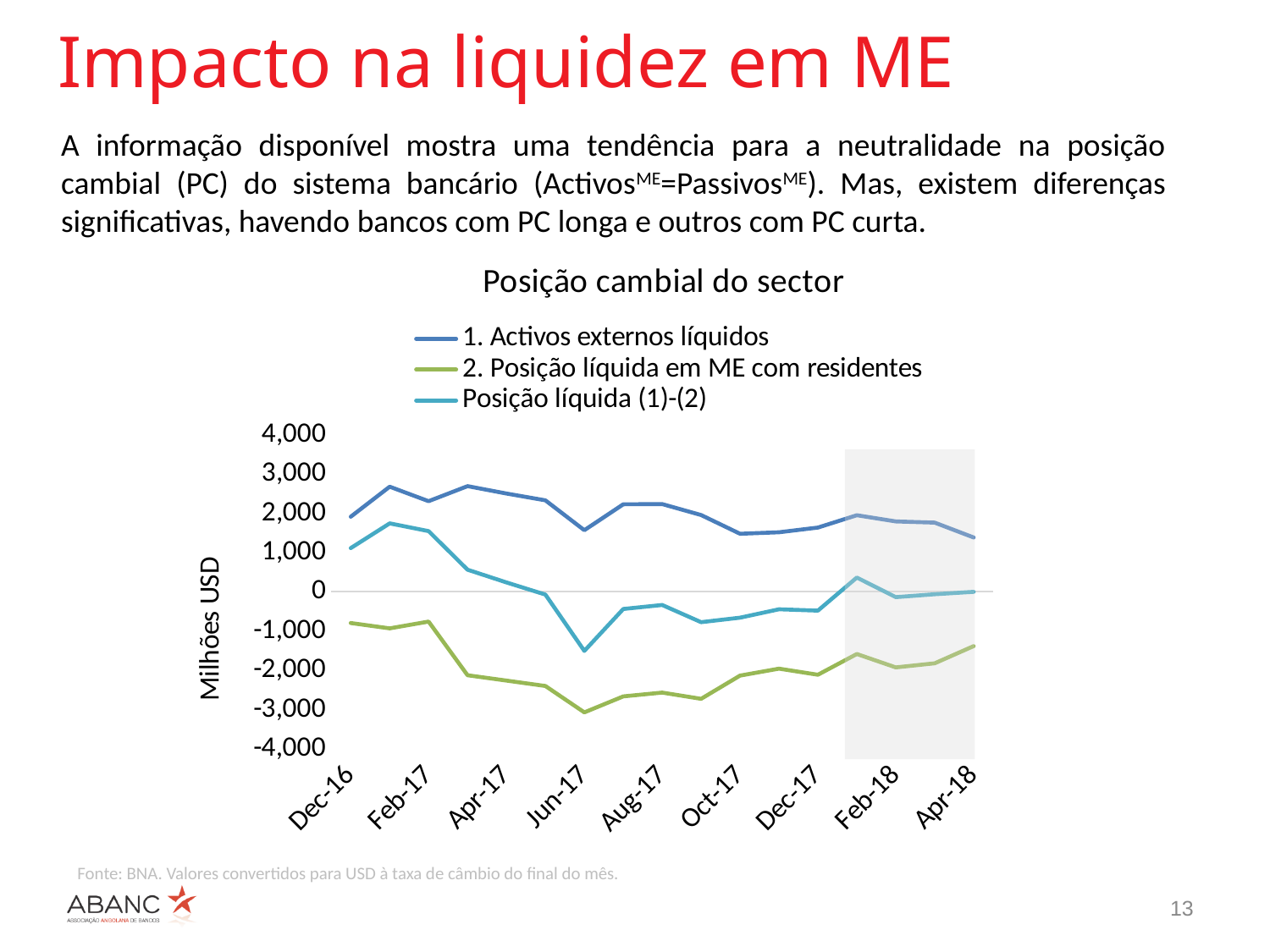
How many date labels are shown along the x axis of the chart? 9 What is the title of the chart? Posição cambial do sector What kind of chart is shown on the slide? line chart At Jun-17, which series has the higher value: '1. Activos externos líquidos' or 'Posição líquida (1)-(2)'? 1. Activos externos líquidos At which month does the series '2. Posição líquida em ME com residentes' reach its lowest value? Jun-17 Does the series '1. Activos externos líquidos' rise or fall between Dec-17 and Apr-18? fall Is the value of '1. Activos externos líquidos' at Jun-17 greater or less than 2,000? less Is the value of '1. Activos externos líquidos' at Dec-16 greater or less than 1,000? greater How many series does the chart legend list? 3 What is the label on the vertical axis of the chart? Milhões USD Is the value of 'Posição líquida (1)-(2)' at Jun-17 greater or less than -1,000? less